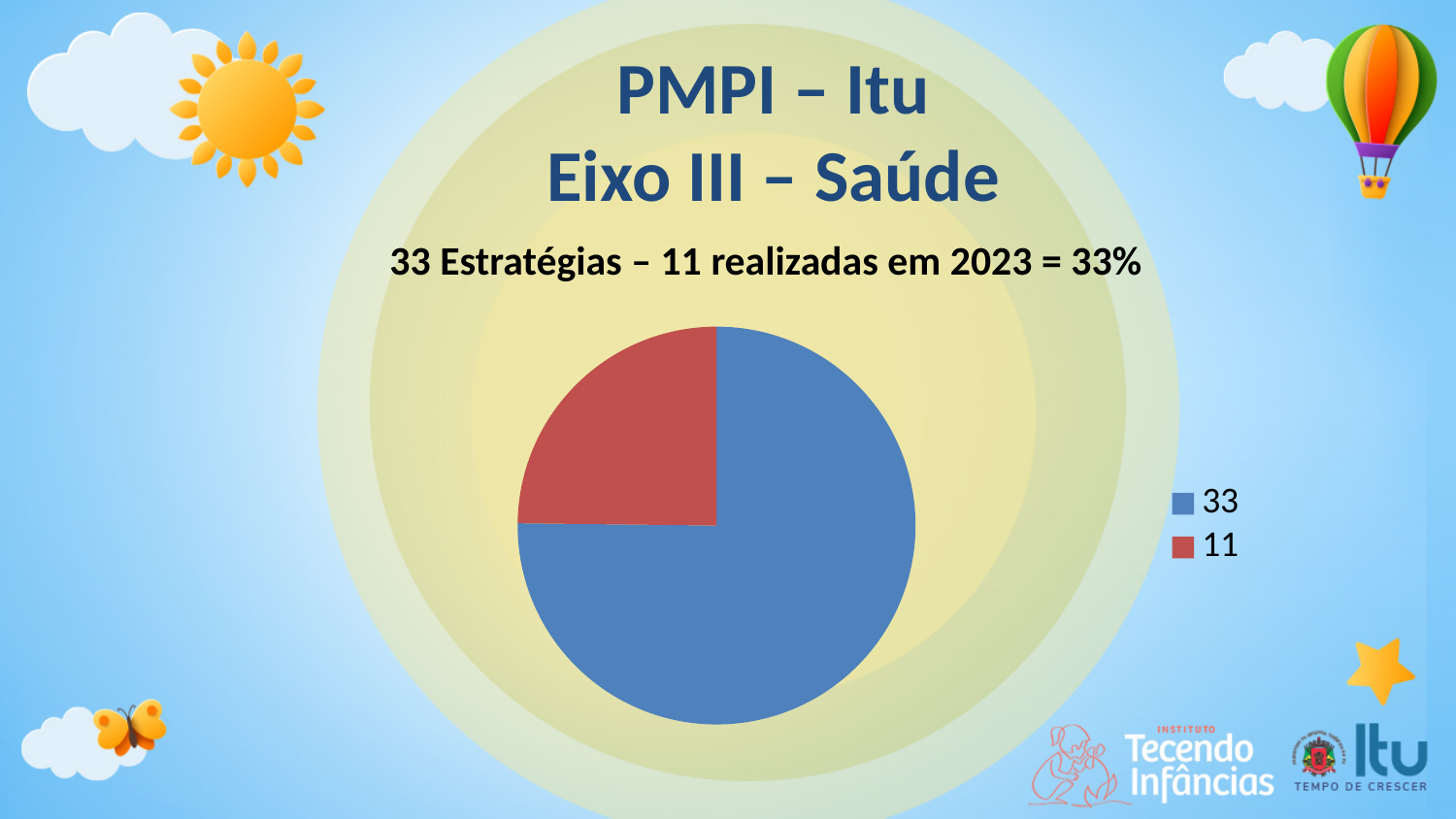
How many entries does the legend of the pie chart list? 2 Is the red slice of the pie chart greater or less than half of the pie? less Which slice of the pie chart is larger, the blue one or the red one? the blue one What colour is the slice labelled 33 in the legend? blue Which legend entry corresponds to the smallest slice of the pie chart? 11 Which legend entry corresponds to the largest slice of the pie chart? 33 How many slices does the pie chart have? 2 What kind of chart is shown on the slide? pie chart Is the blue slice of the pie chart greater or less than half of the pie? greater What colour is the slice labelled 11 in the legend? red